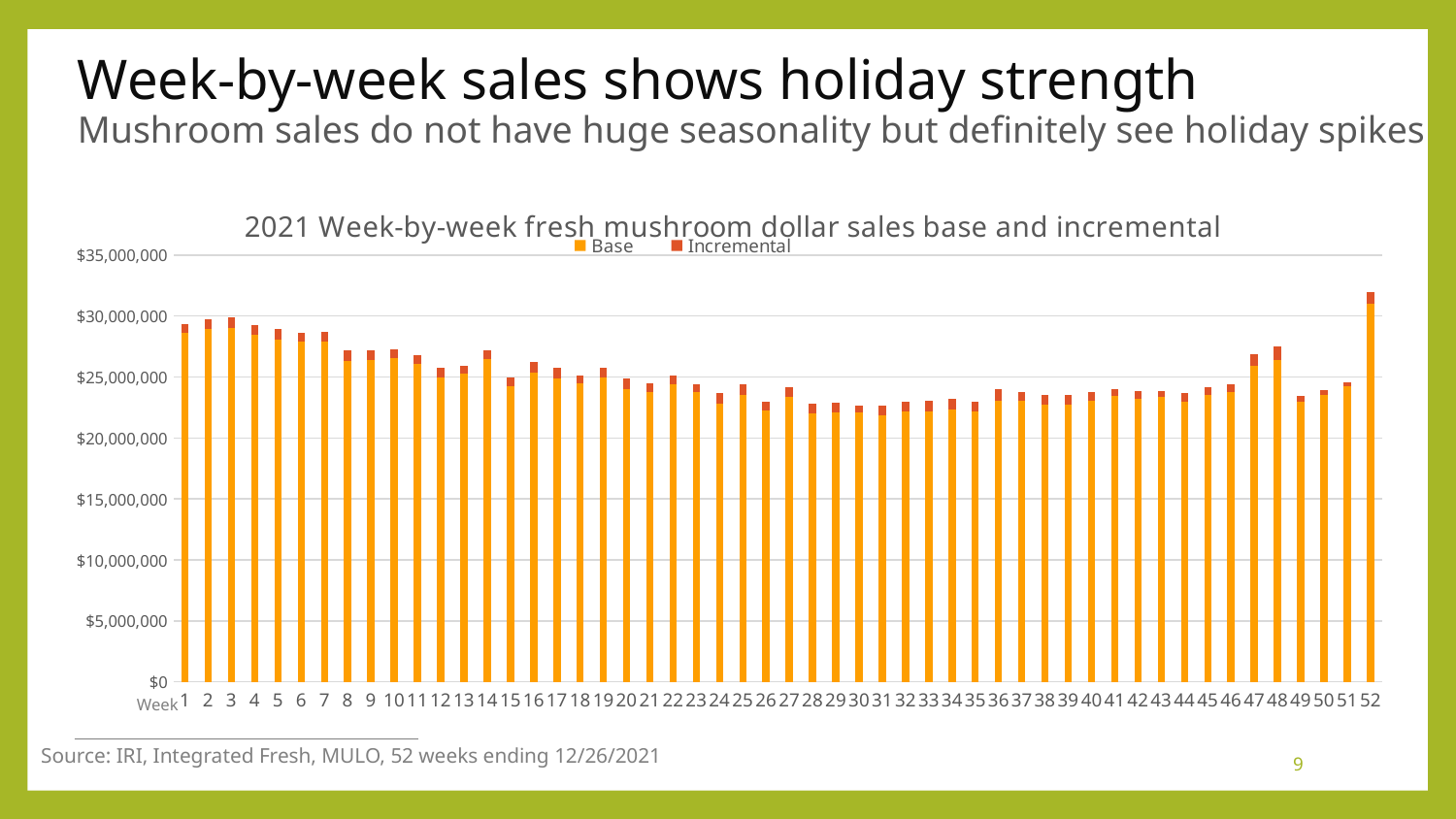
Is the total value for week 26 greater or less than $25,000,000? less Is the total value for week 52 greater or less than $30,000,000? greater How many series does the chart legend list? 2 What is the title of the chart? 2021 Week-by-week fresh mushroom dollar sales base and incremental Which has the larger total dollar sales, week 1 or week 52? Week 52 What kind of chart is shown on the slide? Stacked bar chart Which week has the highest total dollar sales in the chart? Week 52 How many weeks are plotted along the x axis of the chart? 52 Is the total value for week 30 greater or less than $25,000,000? less Do total sales generally rise or fall from week 1 to week 30? Fall Which has the larger total dollar sales, week 48 or week 49? Week 48